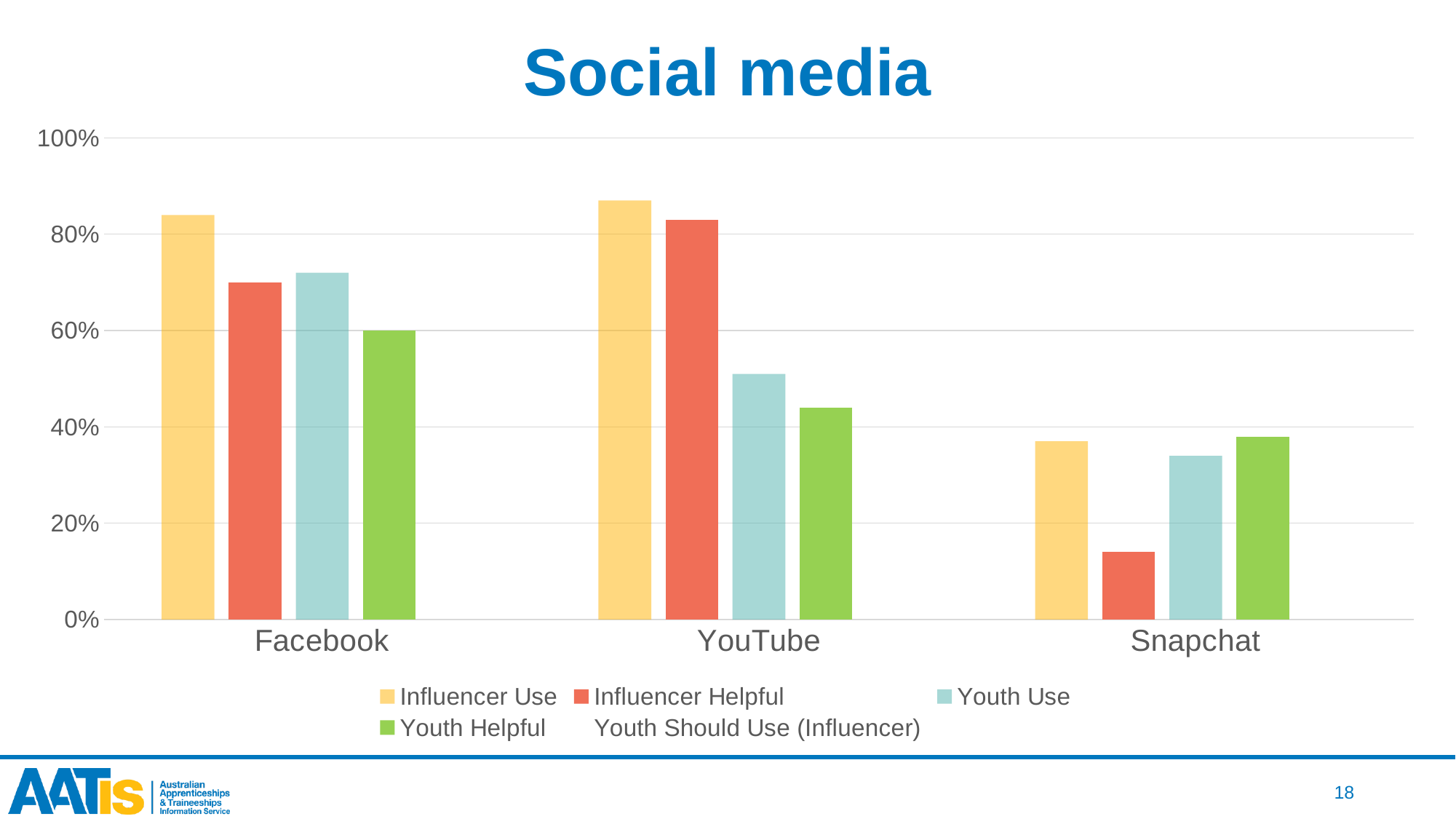
For Facebook, which is larger: Influencer Use or Youth Helpful? Influencer Use Does the Youth Use value rise or fall from Facebook to YouTube to Snapchat? Fall For which platform is the Influencer Use value highest? YouTube What is the Youth Helpful value for Facebook? 60% Is the Influencer Use value for Facebook greater or less than 80%? greater How many series does the legend list? 5 For which platform is the Influencer Helpful value lowest? Snapchat How many platforms (categories) are shown on the x axis? 3 What is the title of the chart? Social media What type of chart is shown on the slide? Bar chart Is the Youth Use value for YouTube greater or less than 40%? greater Is the Influencer Helpful value for Snapchat greater or less than 20%? less